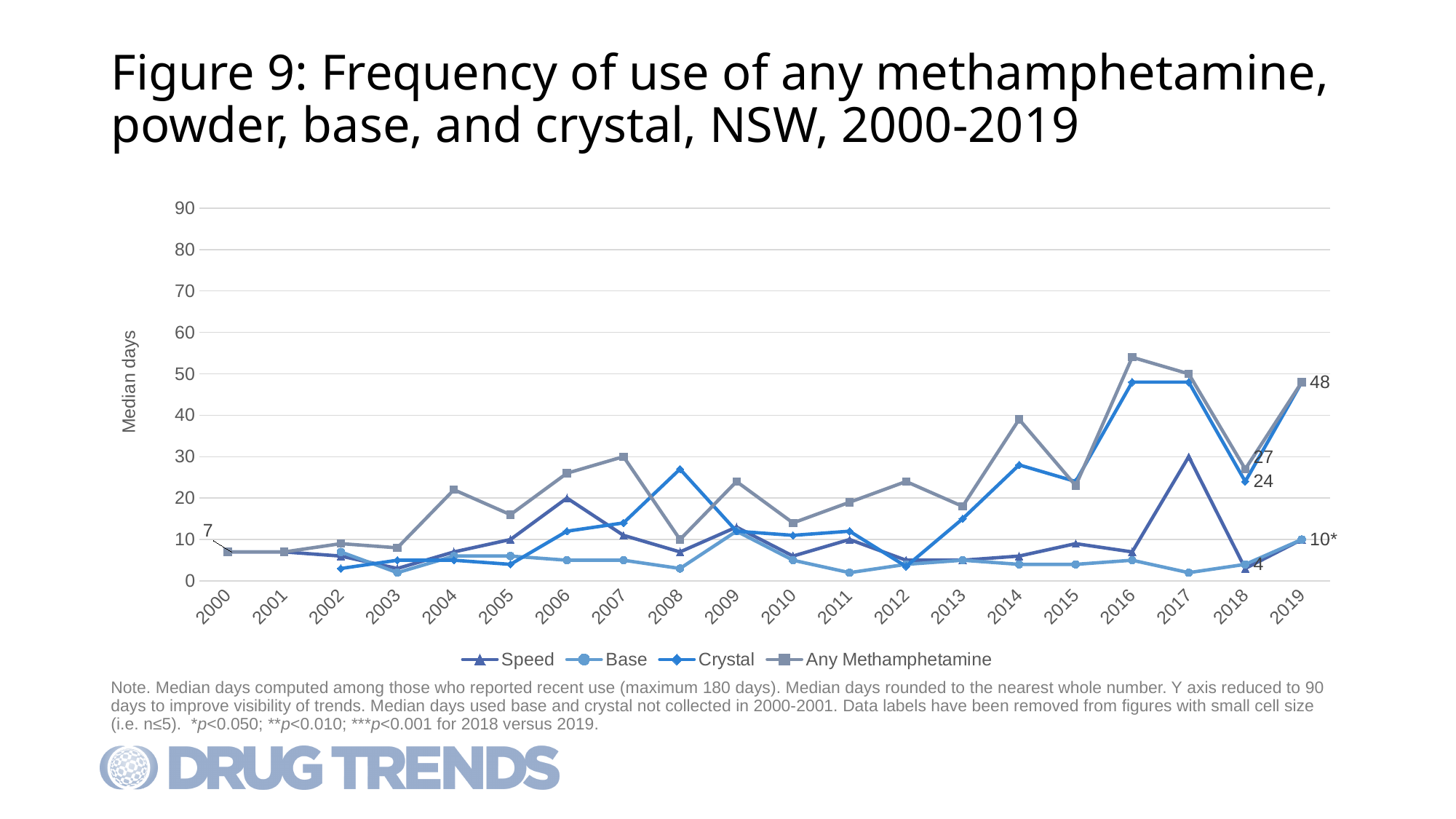
How many series does the legend list? 4 What is the median days value for Any Methamphetamine in 2019? 48 What kind of chart is shown on the slide? line chart How many years are shown on the x axis? 20 Is the value for Any Methamphetamine in 2016 greater or less than 50? greater Which series has the higher value in 2017, Speed or Base? Speed What is the median days value for Any Methamphetamine in 2018? 27 What is the median days value for Any Methamphetamine in 2000? 7 By how much did the Any Methamphetamine value increase from 2018 to 2019? 21 In which year does the Any Methamphetamine series reach its highest value? 2016 What is the difference between the Any Methamphetamine and Crystal values in 2018? 3 What is the median days value for Crystal in 2018? 24